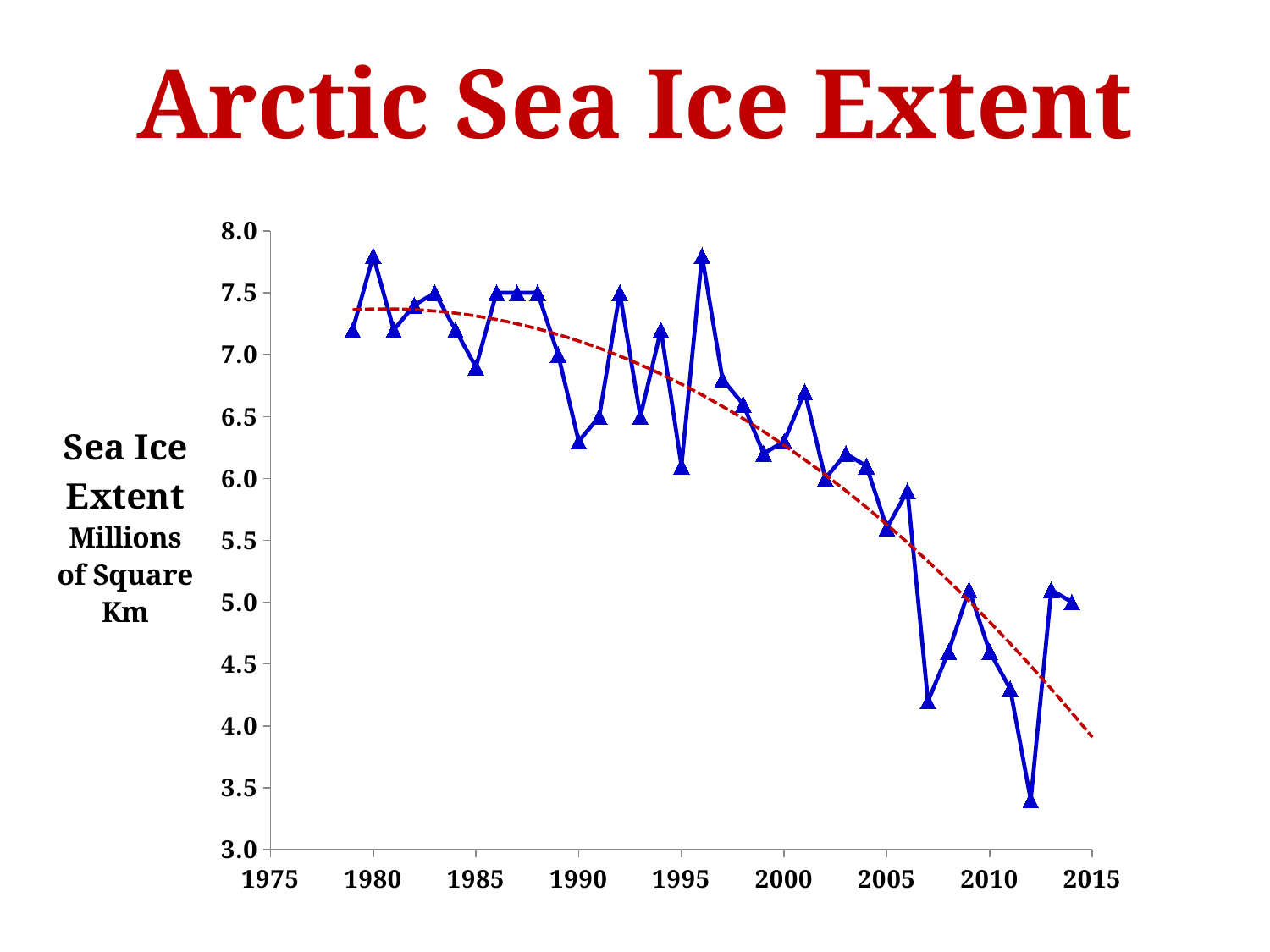
What kind of chart is shown on the slide? Line chart In which year is the sea ice extent lowest? 2012 Which year has the larger sea ice extent, 2007 or 2008? 2008 What unit is the sea ice extent measured in on the y axis? Millions of Square Km Is the sea ice extent for 2007 greater or less than 4.5? less Is the sea ice extent for 1980 greater or less than 7.5? greater What is the title of the chart? Arctic Sea Ice Extent Which year has the larger sea ice extent, 1985 or 1986? 1986 Is the sea ice extent for 2006 greater or less than 5.5? greater Overall, do the sea ice extent values rise or fall from 1979 to 2014? Fall